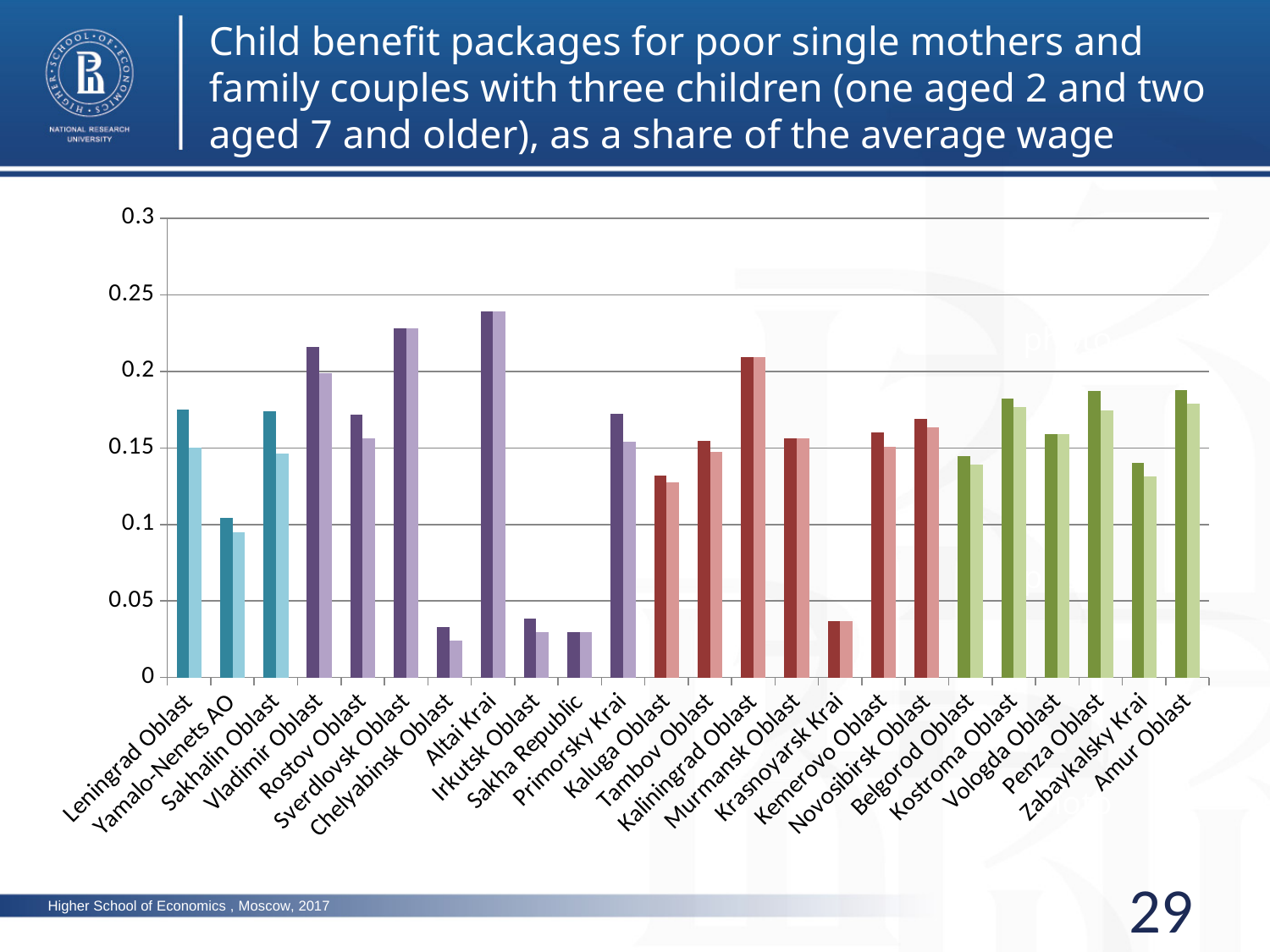
Which region has higher values, Sakhalin Oblast or Yamalo-Nenets AO? Sakhalin Oblast Are the values for Sverdlovsk Oblast greater or less than 0.2? greater What is the highest value shown on the y axis of the chart? 0.3 Are the values for Yamalo-Nenets AO greater or less than 0.15? less Which region has higher values, Altai Krai or Chelyabinsk Oblast? Altai Krai How many regions are shown on the x axis of the chart? 24 Are the values for Chelyabinsk Oblast greater or less than 0.05? less What kind of chart is shown on the slide? bar chart How many bars are plotted for each region in the chart? 2 Which region has the highest bar in the chart? Altai Krai